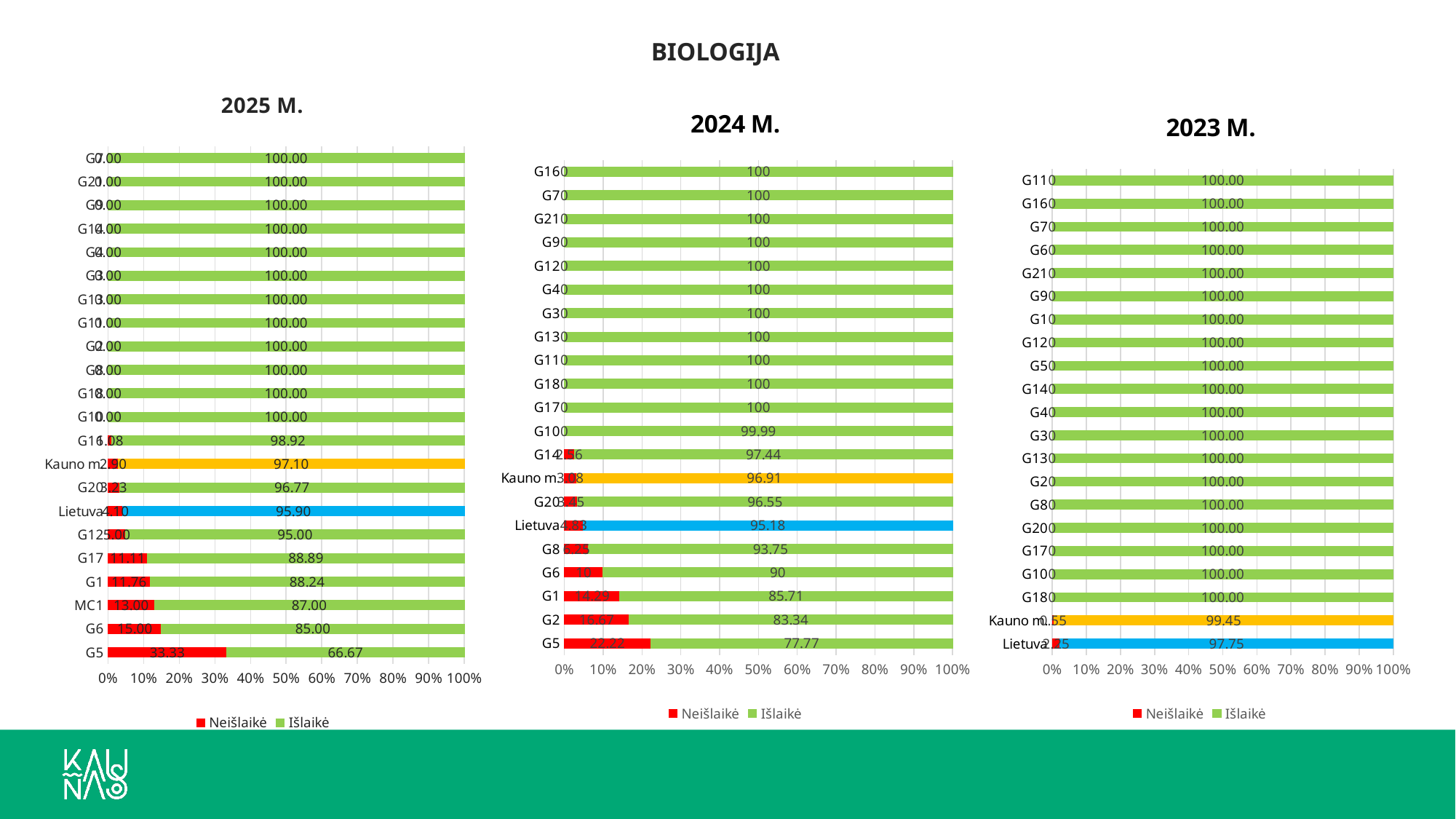
In the 2024 M. chart, which has the larger Išlaikė value, G1 or G2? G1 What kind of chart is the 2023 M. chart? Bar chart In the 2024 M. chart, what is the Išlaikė value for G6? 90 In the 2023 M. chart, what is the Išlaikė value for Lietuva? 97.75 In the 2023 M. chart, what is the Išlaikė value for Kauno m.? 99.45 In the 2025 M. chart, what is the Neišlaikė value for MC1? 13.00 In the 2025 M. chart, what is the difference between the Išlaikė values for G6 and G5? 18.33 How many series does the legend of the 2025 M. chart list? 2 In the 2024 M. chart, what is the Neišlaikė value for G5? 22.22 In the 2025 M. chart, which category has the lowest Išlaikė value? G5 In the 2025 M. chart, what is the Išlaikė value for G5? 66.67 In the 2024 M. chart, which category has the highest Neišlaikė value? G5